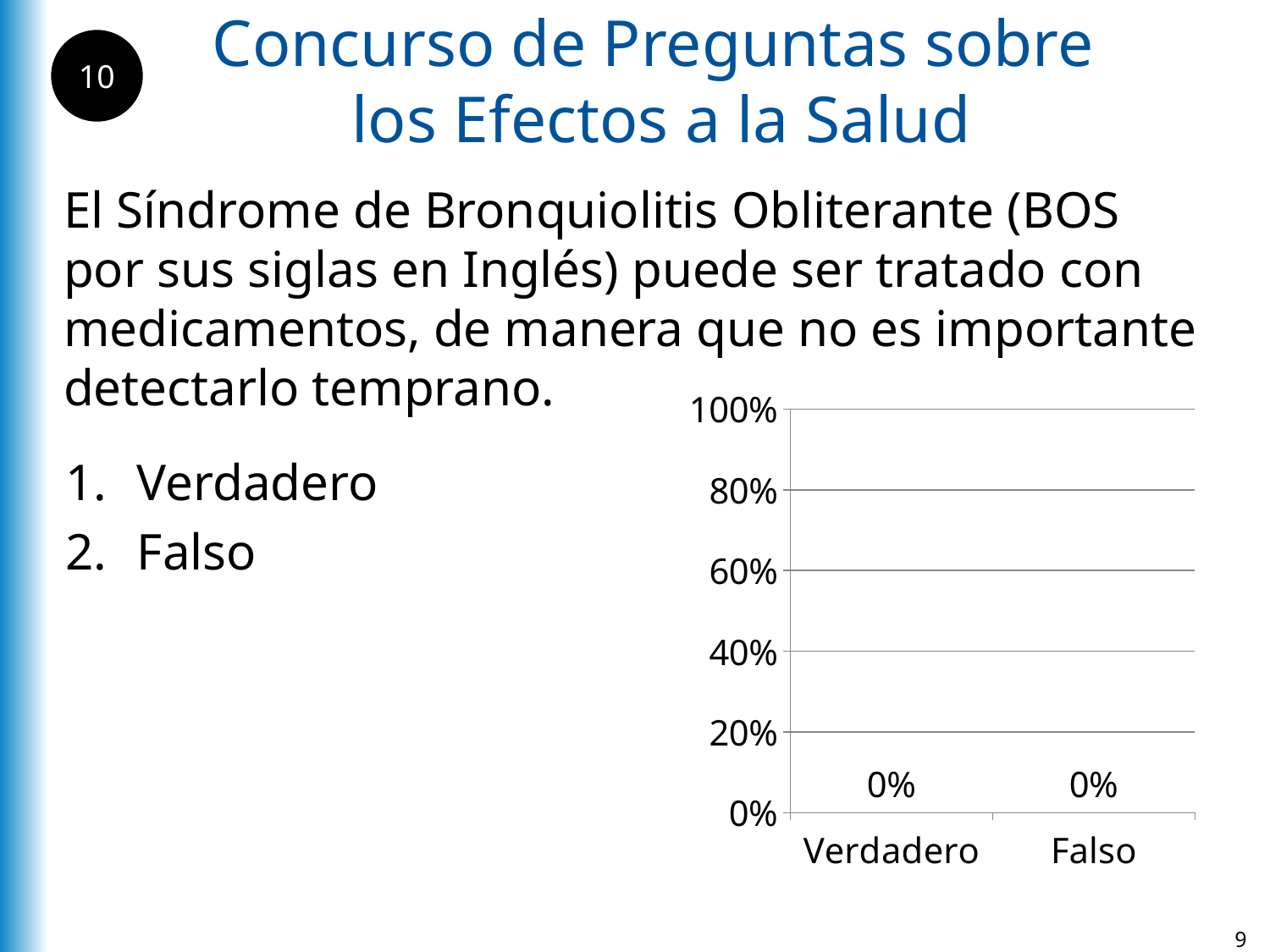
How many categories are shown on the x axis of the chart? 2 Is the value for Verdadero greater or less than 20%? less What are the category labels on the x axis of the chart? Verdadero, Falso What kind of chart is shown on the slide? bar chart Is the value for Falso greater or less than 20%? less What is the value for Falso in the chart? 0% What is the value for Verdadero in the chart? 0% What is the difference between the values for Verdadero and Falso? 0% What is the highest value shown on the chart's vertical axis? 100%